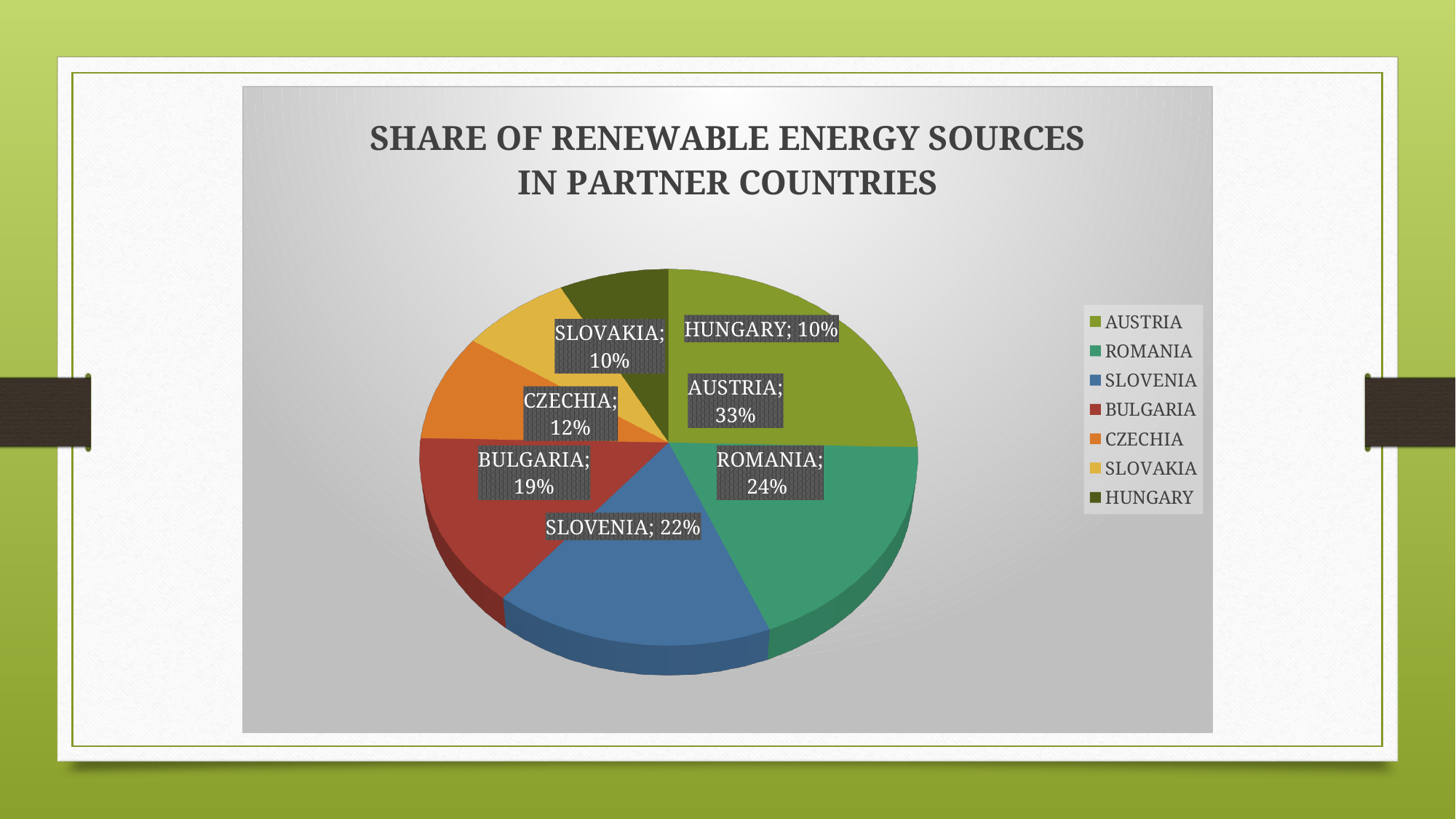
What kind of chart is shown on the slide? pie chart What is the value shown for Romania? 24% Which country has the largest slice of the pie? Austria What is the value shown for Slovenia? 22% What is the title of the chart? SHARE OF RENEWABLE ENERGY SOURCES IN PARTNER COUNTRIES What is the value shown for Czechia? 12% What is the difference in percentage points between Austria and Romania? 9 How many entries does the legend list? 7 How many countries are shown in the pie chart? 7 Which has the larger value, Romania or Slovenia? Romania What is the value shown for Bulgaria? 19% What is the value shown for Austria? 33%